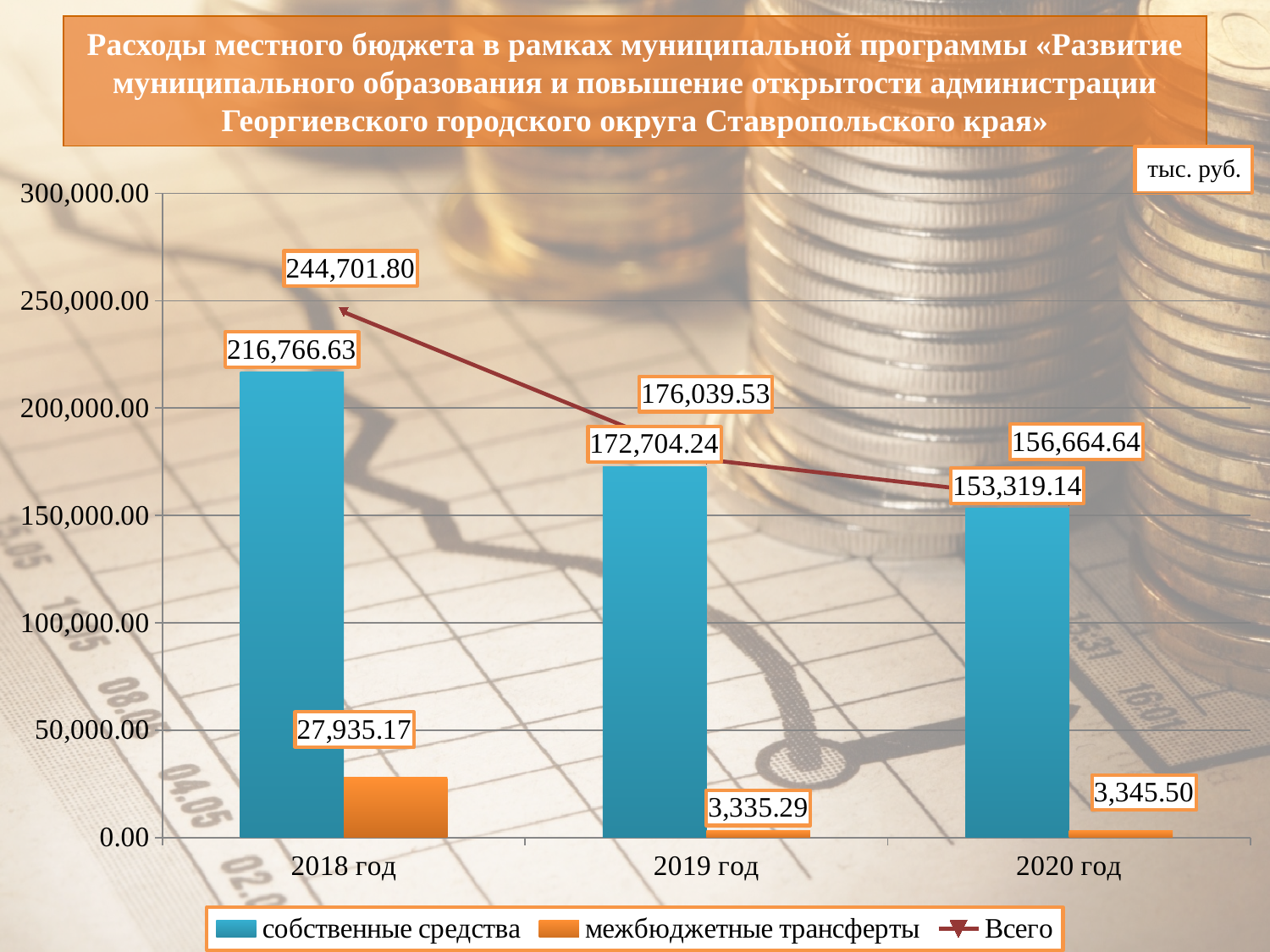
How many years are shown on the x axis? 3 In which year is Всего lowest? 2020 год Does the Всего line rise or fall from 2018 год to 2020 год? fall How many series does the legend list? 3 Which is larger: межбюджетные трансферты in 2018 год or in 2020 год? 2018 год What is the value of межбюджетные трансферты for 2019 год? 3,335.29 What is the value of собственные средства for 2018 год? 216,766.63 Is the value of собственные средства for 2020 год greater or less than 150,000.00? greater In which year is собственные средства highest? 2018 год What is the difference between собственные средства in 2018 год and 2019 год? 44,062.39 What is the value of Всего for 2020 год? 156,664.64 What is the value of межбюджетные трансферты for 2020 год? 3,345.50